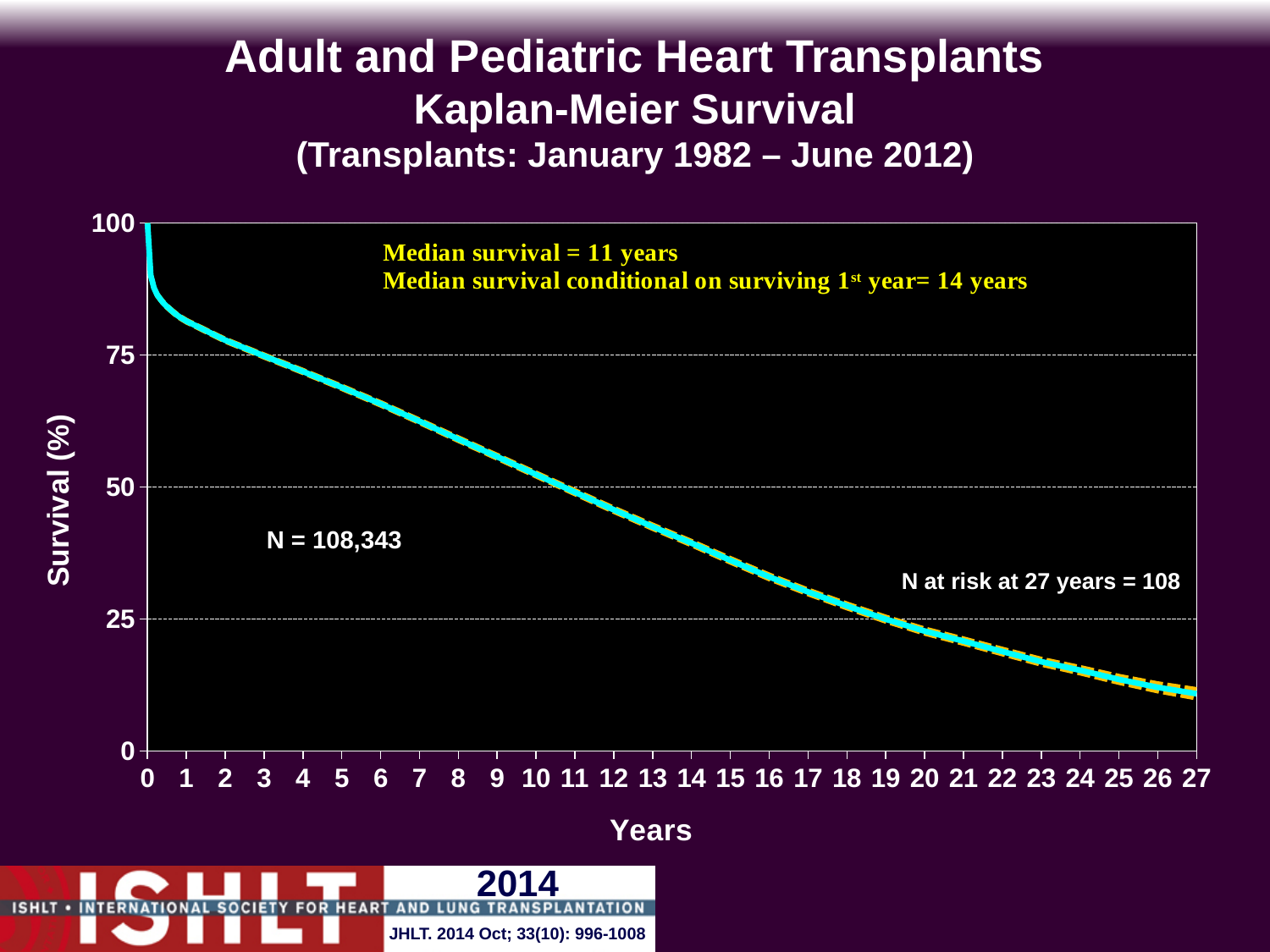
What is the last year shown on the x axis? 27 Is the survival value at 5 years greater or less than 50? greater What is the N (number of transplants) shown on the chart? 108,343 What is the N at risk at 27 years? 108 What is the median survival shown on the chart? 11 years What is the label of the y axis? Survival (%) What kind of chart is shown on the slide? line chart Is the survival value at 1 year greater or less than 75? greater What is the median survival conditional on surviving the 1st year? 14 years Is the survival value at 20 years greater or less than 25? less Does the survival curve rise or fall as years increase? fall